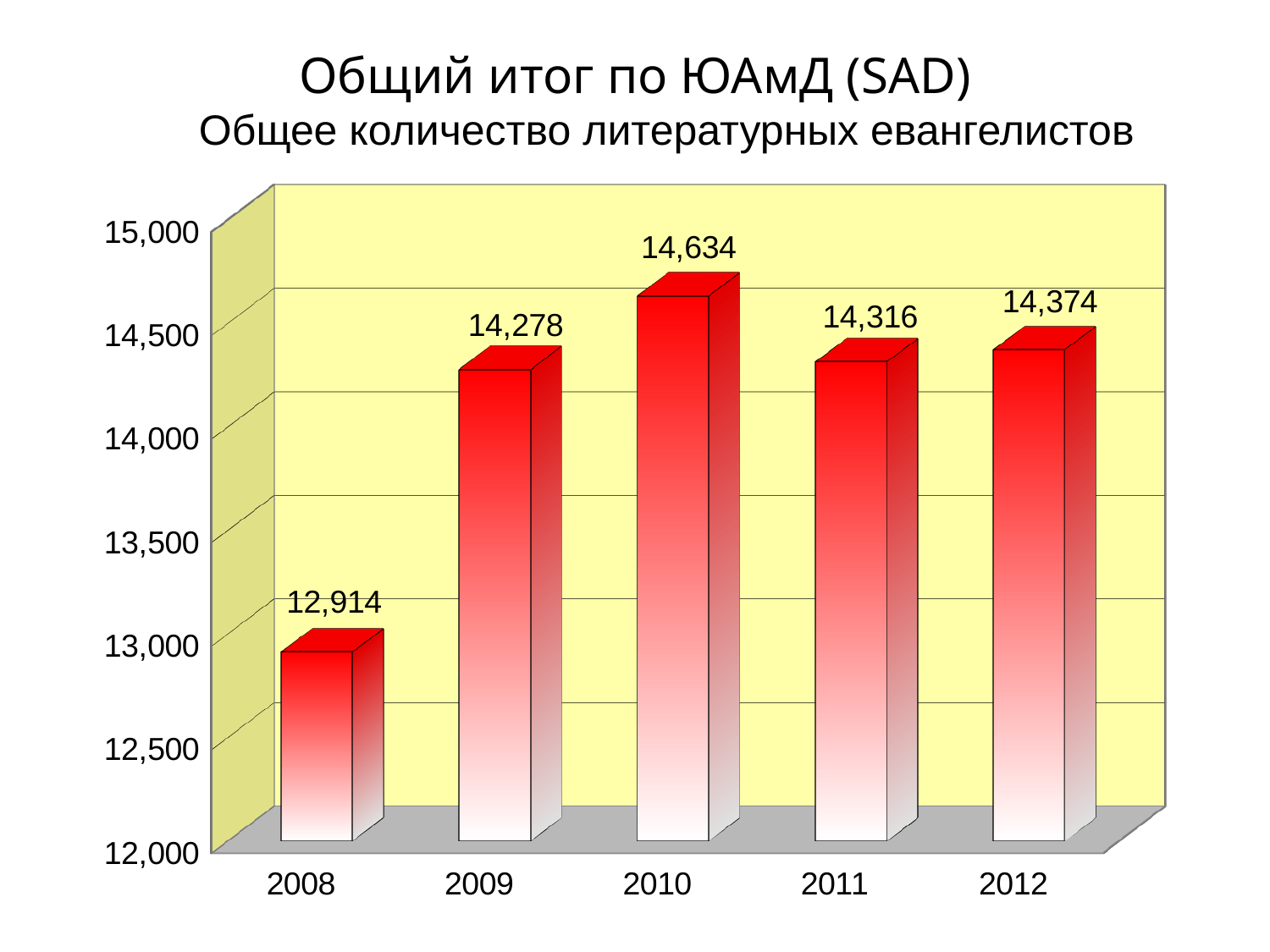
What is the difference between the values for 2012 and 2008? 1,460 What is the subtitle of the chart? Общее количество литературных евангелистов Is the value for 2008 greater or less than 13,000? less What is the value for 2010? 14,634 Which year has the highest value? 2010 Which year has the lowest value? 2008 What is the difference between the values for 2010 and 2009? 356 Which is larger, the value for 2011 or the value for 2009? 2011 What is the value for 2012? 14,374 What is the value for 2008? 12,914 How many years are shown on the x axis? 5 What kind of chart is shown on the slide? bar chart